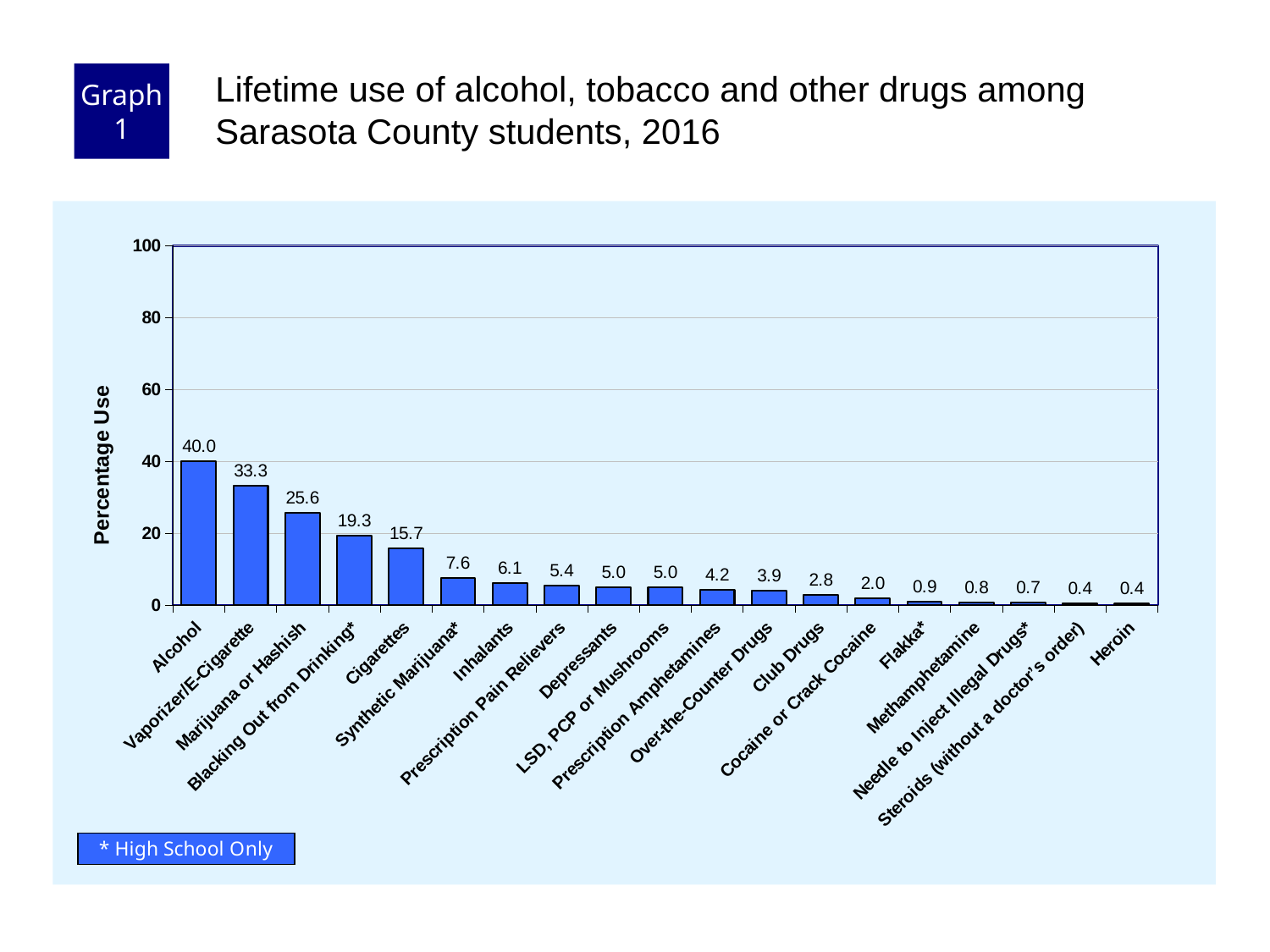
What is the difference between the values for Alcohol and Vaporizer/E-Cigarette? 6.7 What kind of chart is shown on the slide? bar chart Do the values rise or fall from left to right along the x axis? fall What is the value for Club Drugs? 2.8 Which category has the highest value? Alcohol What is the difference between the values for Cigarettes and Synthetic Marijuana*? 8.1 What is the value for Heroin? 0.4 How many categories are shown on the x axis? 19 What is the value for Alcohol? 40.0 Is the value for Marijuana or Hashish greater or less than 20? greater What is the value for Cigarettes? 15.7 Which is larger, the value for Inhalants or the value for Synthetic Marijuana*? Synthetic Marijuana*